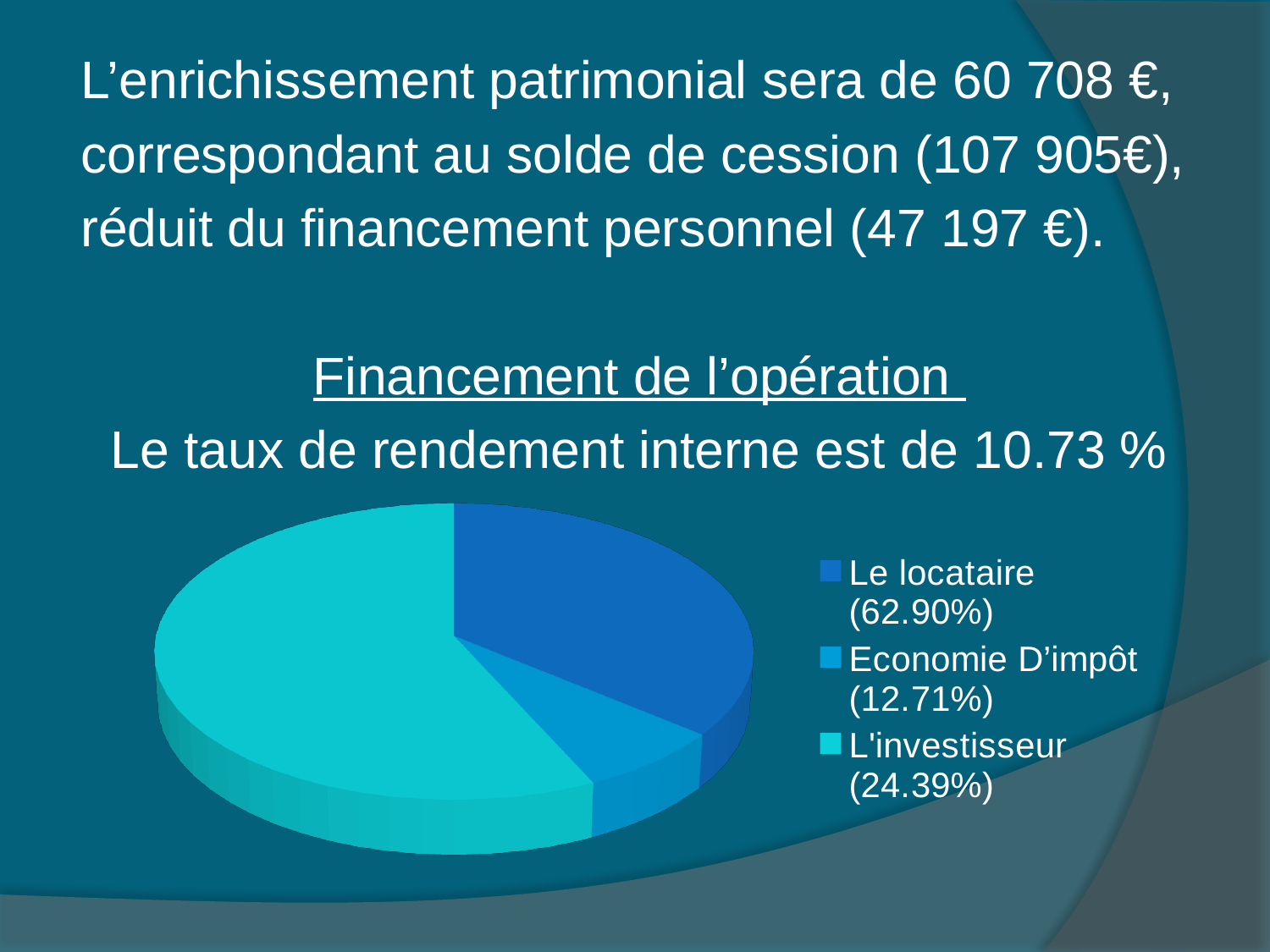
According to the legend percentages, which category has the smallest share? Economie D'impôt What is the difference between the percentages for Le locataire and L'investisseur? 38.51% How many entries does the legend of the pie chart list? 3 What percentage is shown for Le locataire in the pie chart legend? 62.90% How many slices does the pie chart have? 3 What kind of chart is shown on the slide? Pie chart What percentage is shown for Economie D'impôt in the pie chart legend? 12.71% What percentage is shown for L'investisseur in the pie chart legend? 24.39% What is the difference between the percentages for L'investisseur and Economie D'impôt? 11.68% What is the underlined heading above the pie chart? Financement de l'opération Which has the larger percentage in the legend, L'investisseur or Economie D'impôt? L'investisseur According to the legend percentages, which category has the largest share? Le locataire